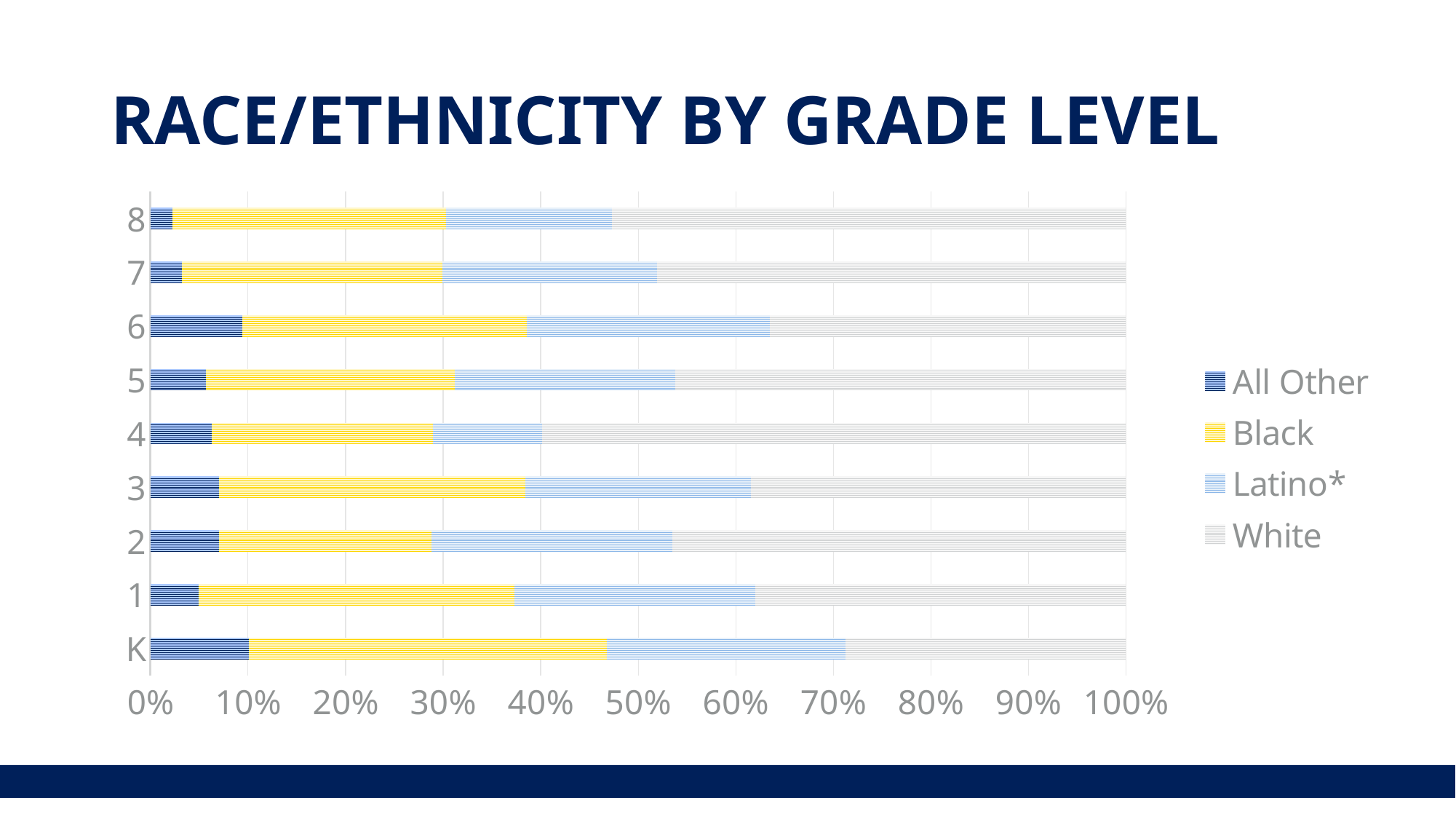
What kind of chart is shown on the slide? Stacked bar chart Is the Latino* share for grade 4 greater or less than 20%? less Is the Black share for grade K greater or less than 30%? greater Which grade has the largest White share? 4 Which grade has the larger All Other share, grade K or grade 8? K Is the White share for grade K greater or less than 40%? less How many grade levels are plotted on the chart? 9 How many series does the legend list? 4 Which series is shown in yellow in the legend? Black Which grade has the smallest White share? K What is the title of the chart? RACE/ETHNICITY BY GRADE LEVEL